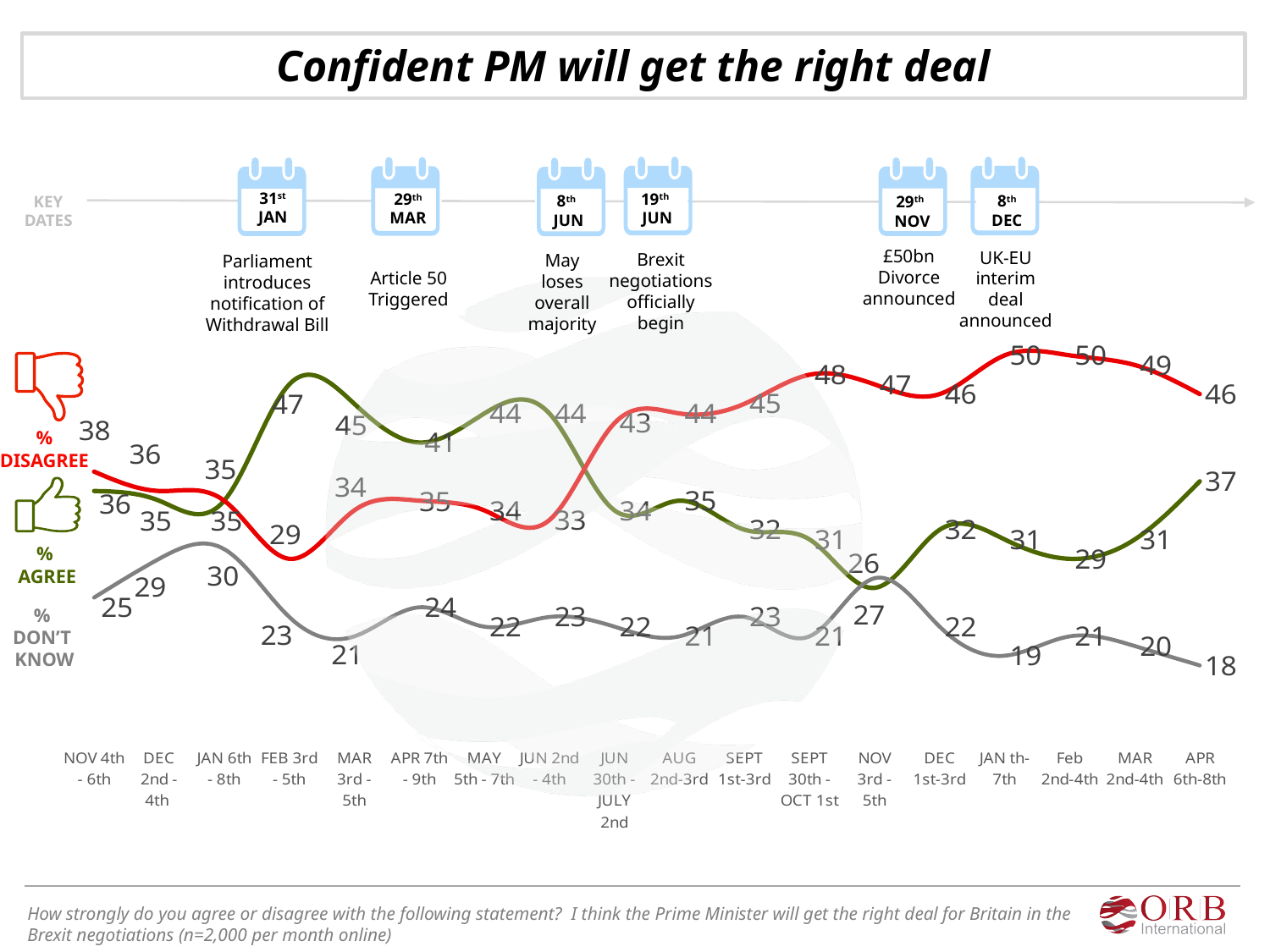
Does the % DISAGREE line rise or fall between JUN 2nd-4th and SEPT 30th-OCT 1st? Rise At which survey date is the % DON'T KNOW value lowest? APR 6th-8th What is the % DISAGREE value for APR 6th-8th? 46 What is the difference between % DISAGREE and % AGREE at APR 6th-8th? 9 What type of chart is shown on the slide? Line chart What is the title of the chart? Confident PM will get the right deal At which survey date is the % AGREE value highest? FEB 3rd-5th What is the % DON'T KNOW value for JAN 6th-8th? 30 How many survey dates are shown along the x axis? 18 Which is larger at FEB 3rd-5th, % AGREE or % DISAGREE? % AGREE What is the % AGREE value for NOV 3rd-5th? 26 How many series are plotted on the chart? 3